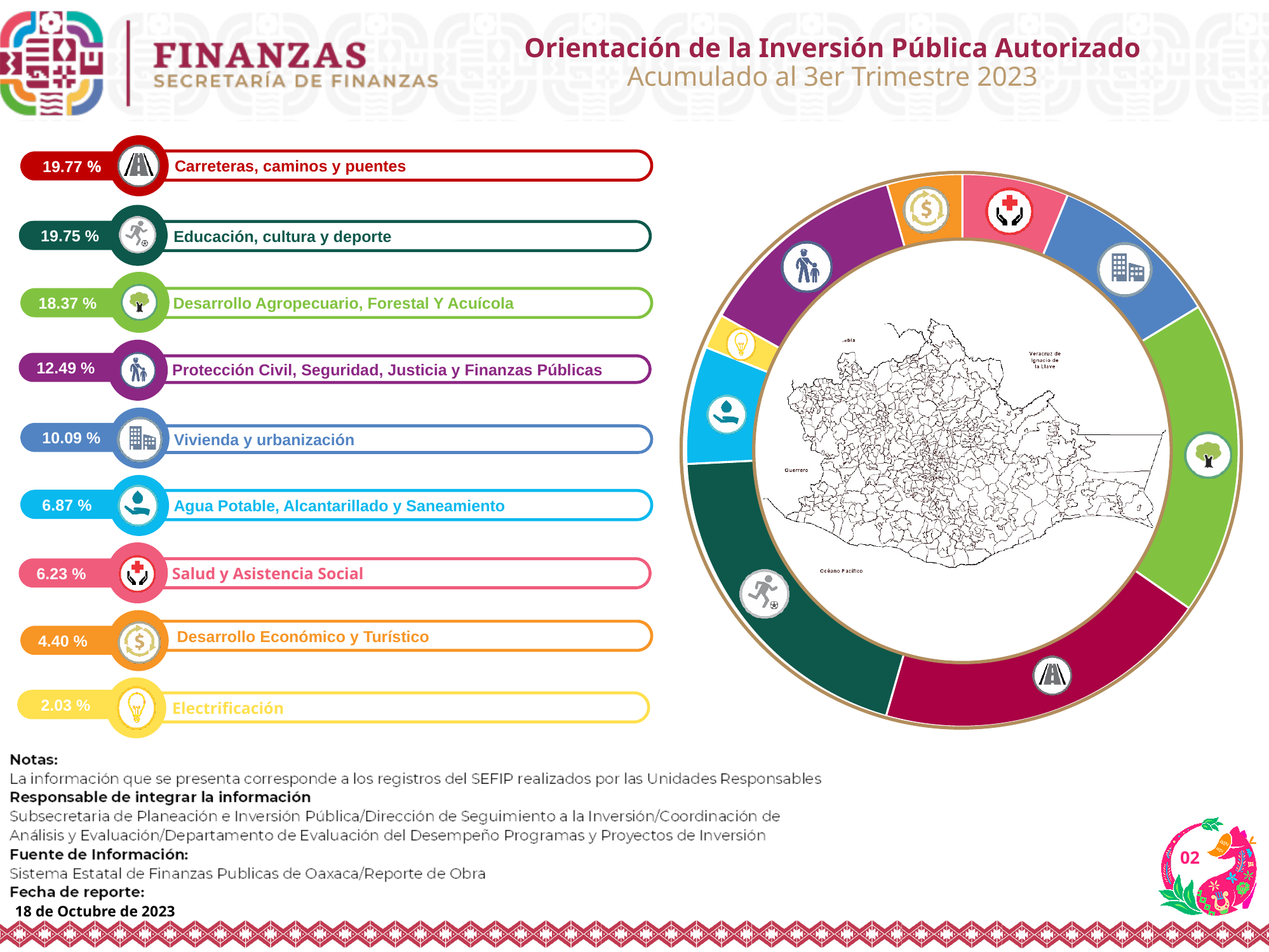
What percentage of the authorized public investment goes to Carreteras, caminos y puentes? 19.77 % What percentage is shown for Electrificación? 2.03 % How many categories are shown in the chart? 9 What kind of chart is used to show the distribution of the authorized public investment? Pie (donut) chart What share does Desarrollo Económico y Turístico have? 4.40 % What share does Educación, cultura y deporte have in the chart? 19.75 % Which has a larger share: Vivienda y urbanización or Agua Potable, Alcantarillado y Saneamiento? Vivienda y urbanización What colour represents Desarrollo Agropecuario, Forestal Y Acuícola in the chart? Green Which category has the smallest share of the authorized public investment? Electrificación What is the difference in percentage points between Carreteras, caminos y puentes and Protección Civil, Seguridad, Justicia y Finanzas Públicas? 7.28 % What is the difference between Agua Potable, Alcantarillado y Saneamiento and Salud y Asistencia Social? 0.64 % What is the value shown for Vivienda y urbanización? 10.09 %